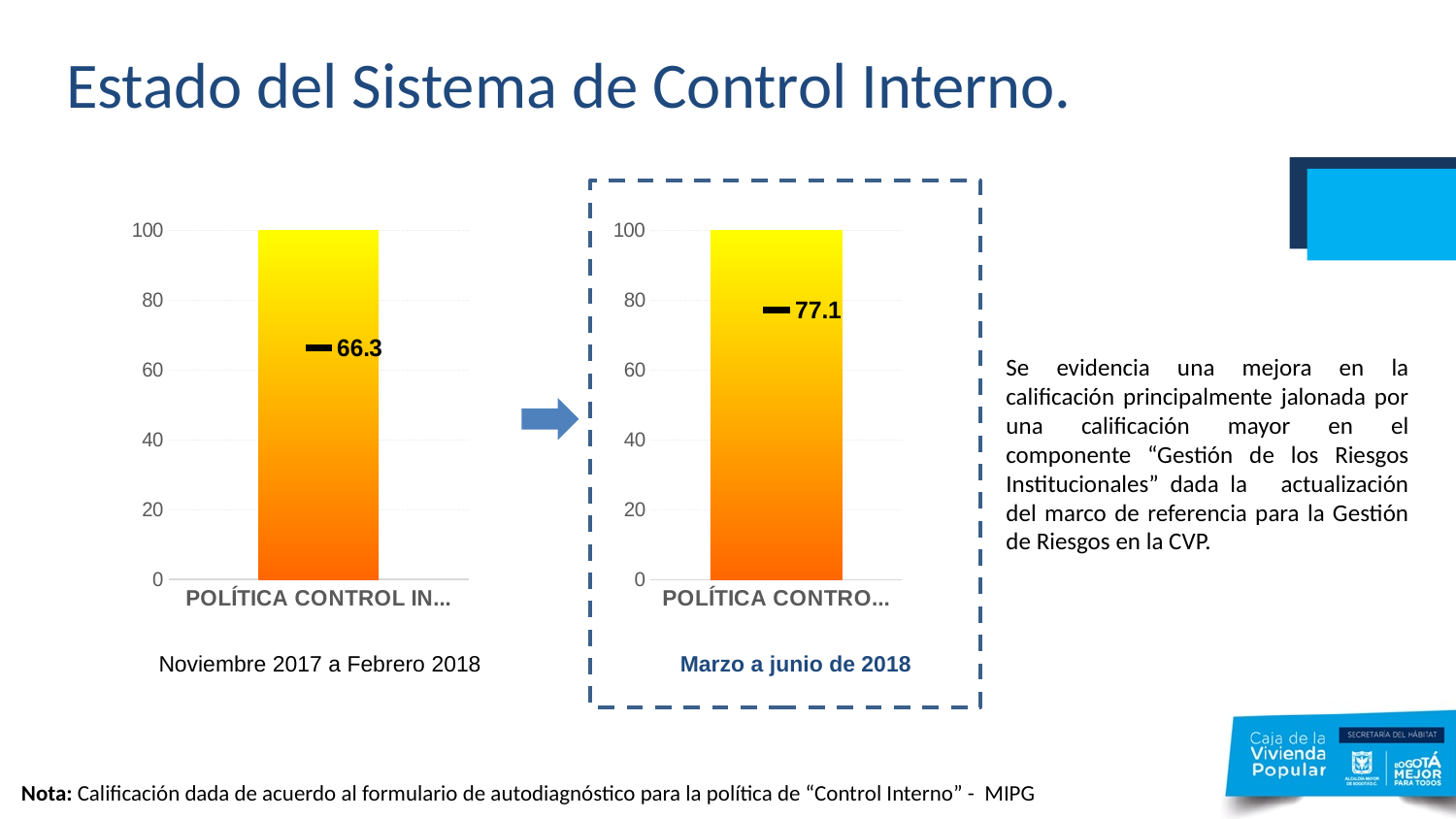
What period label appears below the right chart? Marzo a junio de 2018 In the left chart (Noviembre 2017 a Febrero 2018), is the marked value greater or less than 60? greater What is the difference between the marked value in the Marzo a junio de 2018 chart and the marked value in the Noviembre 2017 a Febrero 2018 chart? 10.8 In the left chart (Noviembre 2017 a Febrero 2018), what value is marked on the bar? 66.3 What kind of chart is used in the left chart (Noviembre 2017 a Febrero 2018)? bar chart Which period shows the higher marked value, Noviembre 2017 a Febrero 2018 or Marzo a junio de 2018? Marzo a junio de 2018 How many bars are plotted in the right chart (Marzo a junio de 2018)? 1 In the right chart (Marzo a junio de 2018), what value is marked on the bar? 77.1 Did the marked value rise or fall from the Noviembre 2017 a Febrero 2018 chart to the Marzo a junio de 2018 chart? rise What is the maximum value shown on the y axis of the left chart (Noviembre 2017 a Febrero 2018)? 100 In the right chart (Marzo a junio de 2018), is the marked value greater or less than 80? less